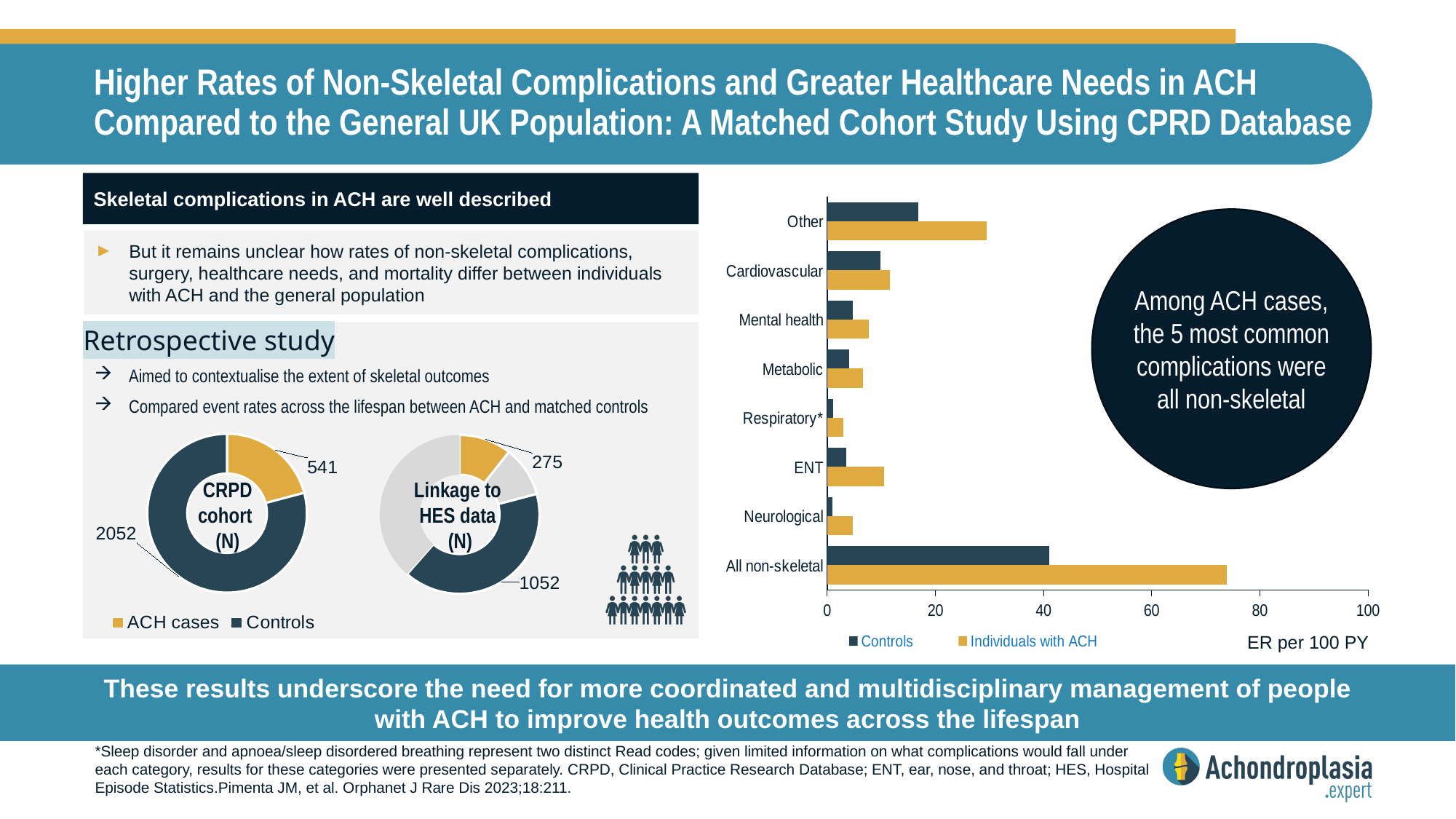
In the Linkage to HES data donut chart, what is the value for Controls? 1052 In the Linkage to HES data donut chart, what is the value for ACH cases? 275 In the Linkage to HES data donut chart, which is larger, ACH cases or Controls? Controls In the CRPD cohort donut chart, how many ACH cases are shown? 541 In the ER per 100 PY bar chart, how many series does the legend list? 2 What kind of chart is the ER per 100 PY chart on the right? Bar chart In the ER per 100 PY bar chart, is the value for Individuals with ACH in the All non-skeletal category greater or less than 60? greater In the ER per 100 PY bar chart, is the value for Individuals with ACH in the Cardiovascular category greater or less than 20? less In the ER per 100 PY bar chart, how many complication categories are shown? 8 In the CRPD cohort donut chart, how many Controls are shown? 2052 In the CRPD cohort donut chart, what is the difference between the Controls and ACH cases values? 1511 In the ER per 100 PY bar chart, which category has the highest value for Individuals with ACH? All non-skeletal